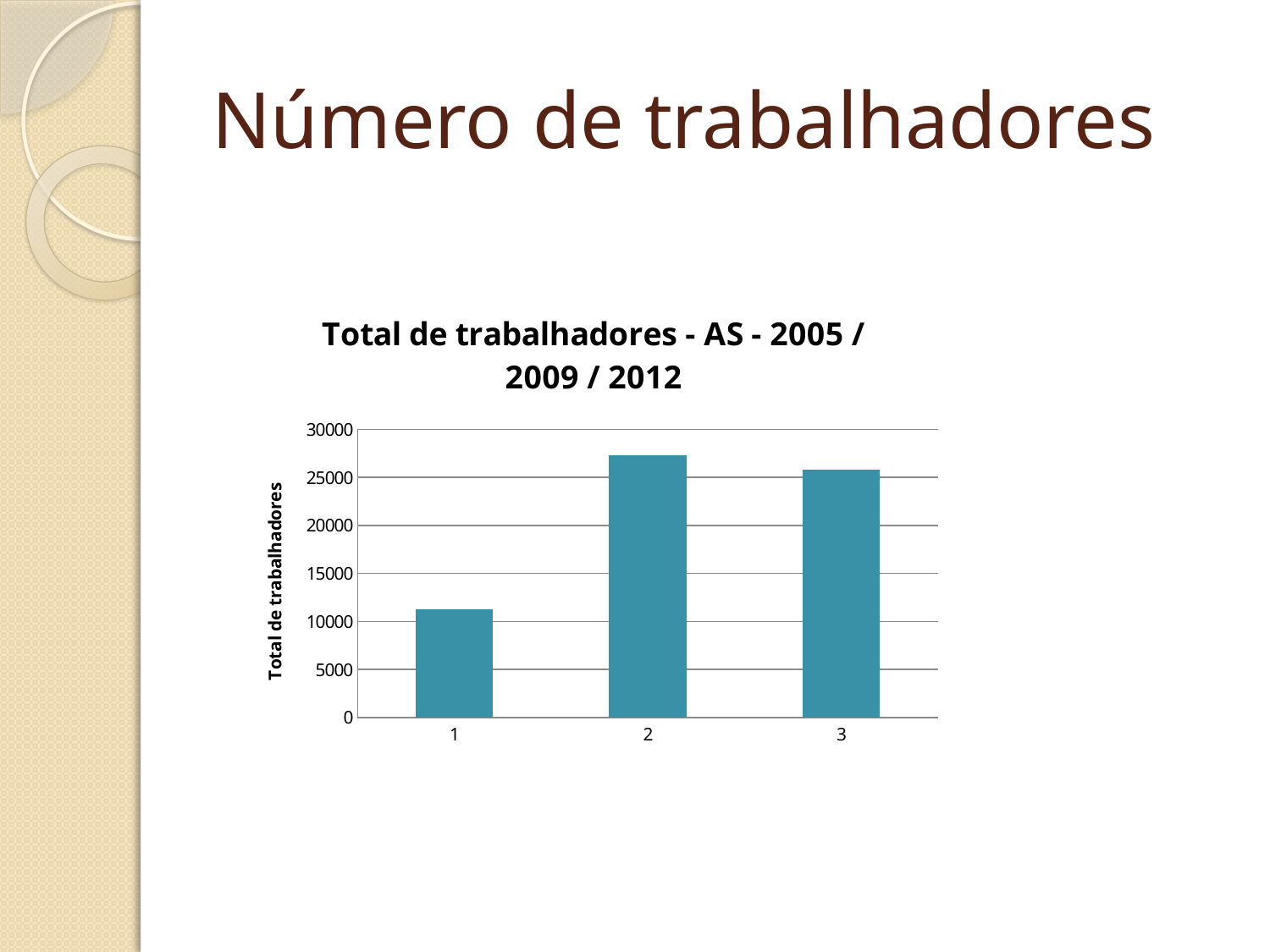
Which has a larger value, category 1 or category 2? 2 Is the value for category 1 greater or less than 15000? less Which category has the lowest value in the chart? 1 Is the value for category 2 greater or less than 25000? greater Which has a larger value, category 2 or category 3? 2 Which category has the highest value in the chart? 2 Is the value for category 1 greater or less than 10000? greater What is the title of the chart? Total de trabalhadores - AS - 2005 / 2009 / 2012 How many bars are plotted in the chart? 3 What kind of chart is shown on the slide? bar chart What is the label on the vertical axis of the chart? Total de trabalhadores